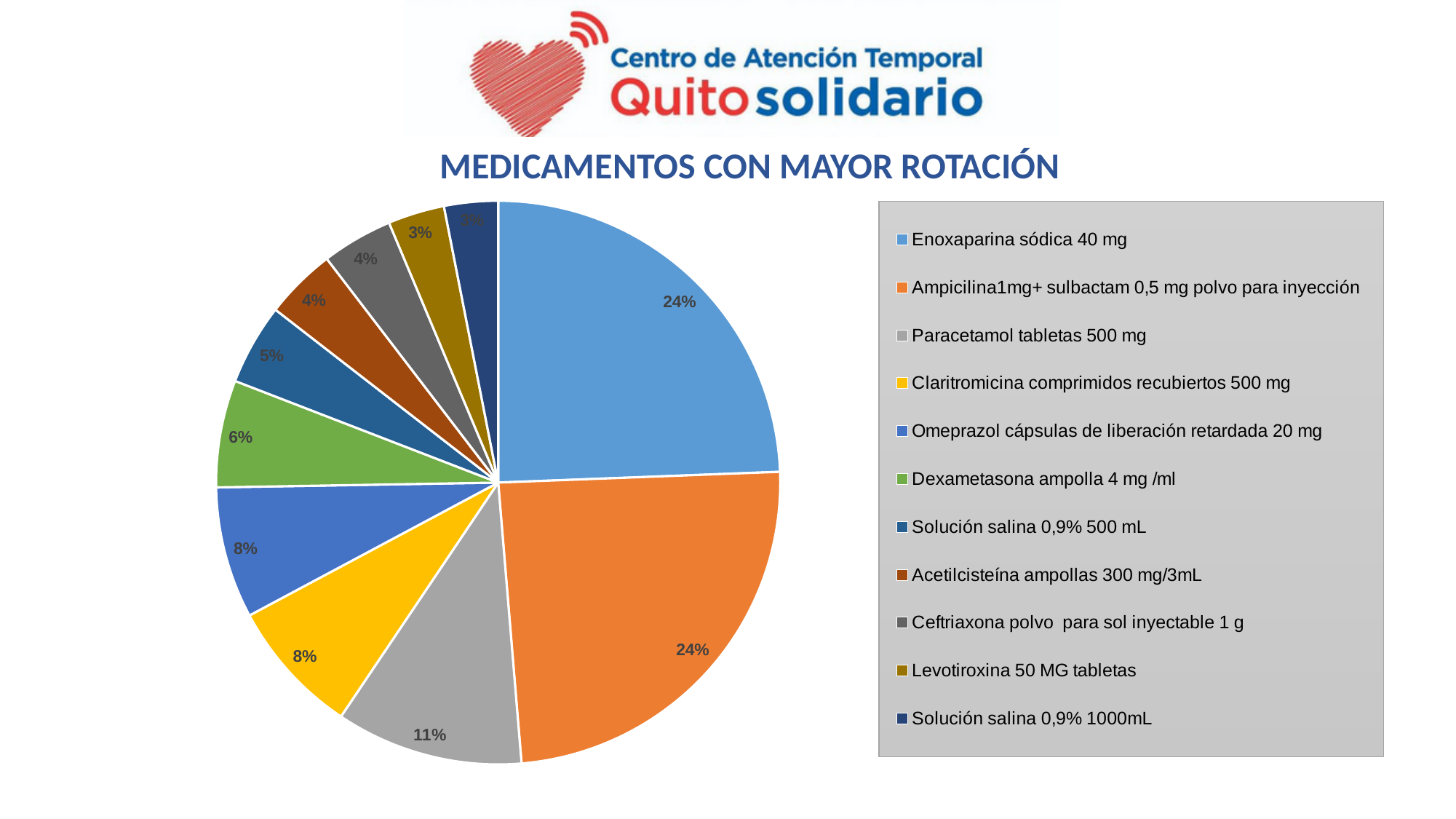
How many slices does the pie chart have? 11 What colour is the slice for Claritromicina comprimidos recubiertos 500 mg? Yellow What share of the pie does Levotiroxina 50 MG tabletas represent? 3% What share of the pie does Solución salina 0,9% 500 mL represent? 5% What share of the pie does Enoxaparina sódica 40 mg represent? 24% What is the combined share of Enoxaparina sódica 40 mg and Ampicilina1mg+ sulbactam 0,5 mg polvo para inyección? 48% What kind of chart is shown on the slide? Pie chart Which has a larger share, Omeprazol cápsulas de liberación retardada 20 mg or Acetilcisteína ampollas 300 mg/3mL? Omeprazol cápsulas de liberación retardada 20 mg What is the title of the chart? MEDICAMENTOS CON MAYOR ROTACIÓN What is the difference between the shares of Paracetamol tabletas 500 mg and Dexametasona ampolla 4 mg /ml? 5%